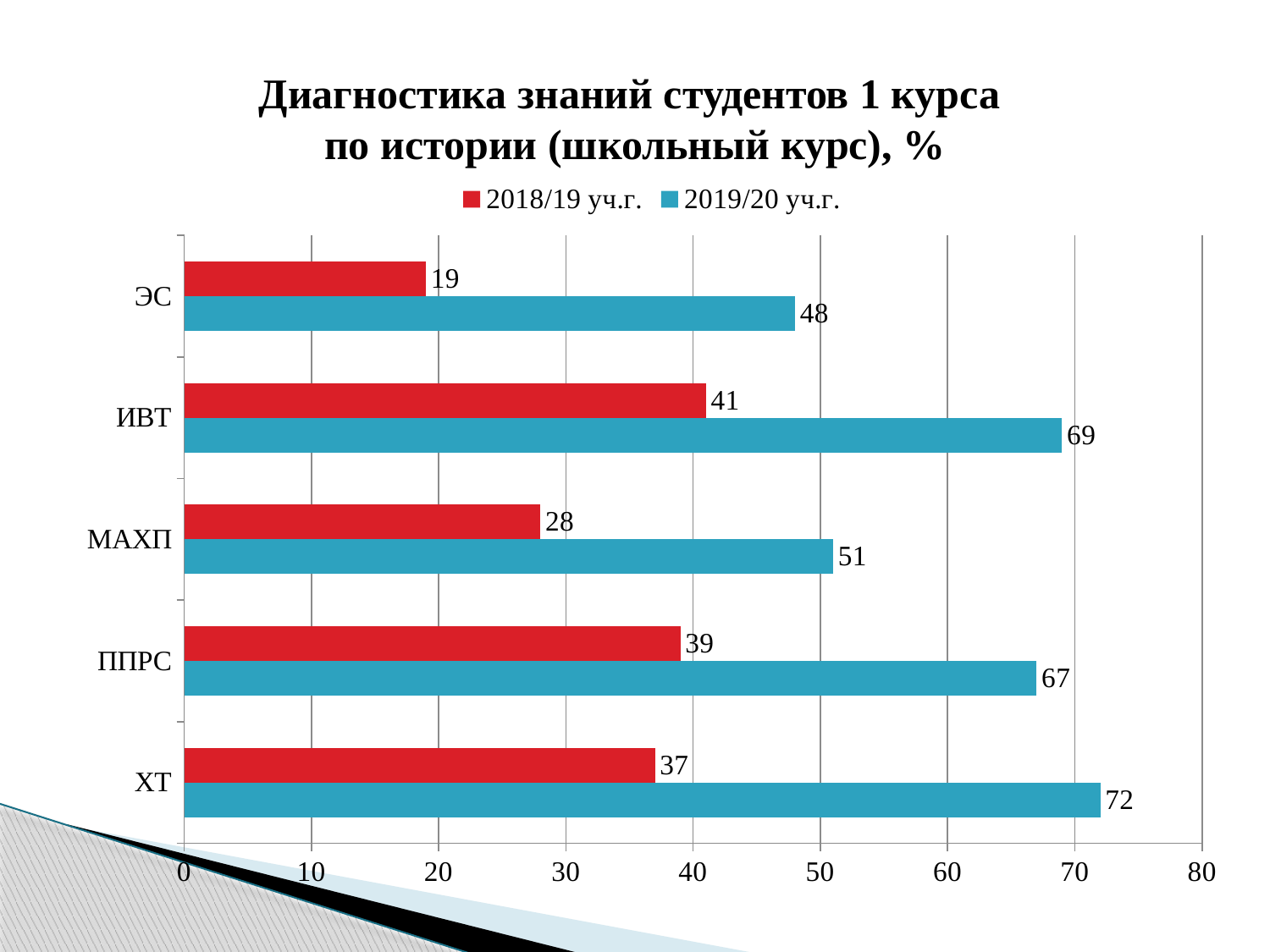
Which colour represents the 2018/19 уч.г. series? red How many categories are shown on the chart? 5 Which category has the highest value in the 2019/20 уч.г. series? ХТ Which is larger: the 2018/19 уч.г. value for ИВТ or the 2018/19 уч.г. value for ППРС? ИВТ How many series does the legend list? 2 Which category has the lowest value in the 2018/19 уч.г. series? ЭС Is the 2019/20 уч.г. value for ЭС greater or less than 40? greater What is the difference between the 2019/20 уч.г. and 2018/19 уч.г. values for МАХП? 23 What is the value for ИВТ in the 2019/20 уч.г. series? 69 What is the value for ППРС in the 2019/20 уч.г. series? 67 What kind of chart is shown on the slide? bar chart What is the value for ЭС in the 2018/19 уч.г. series? 19